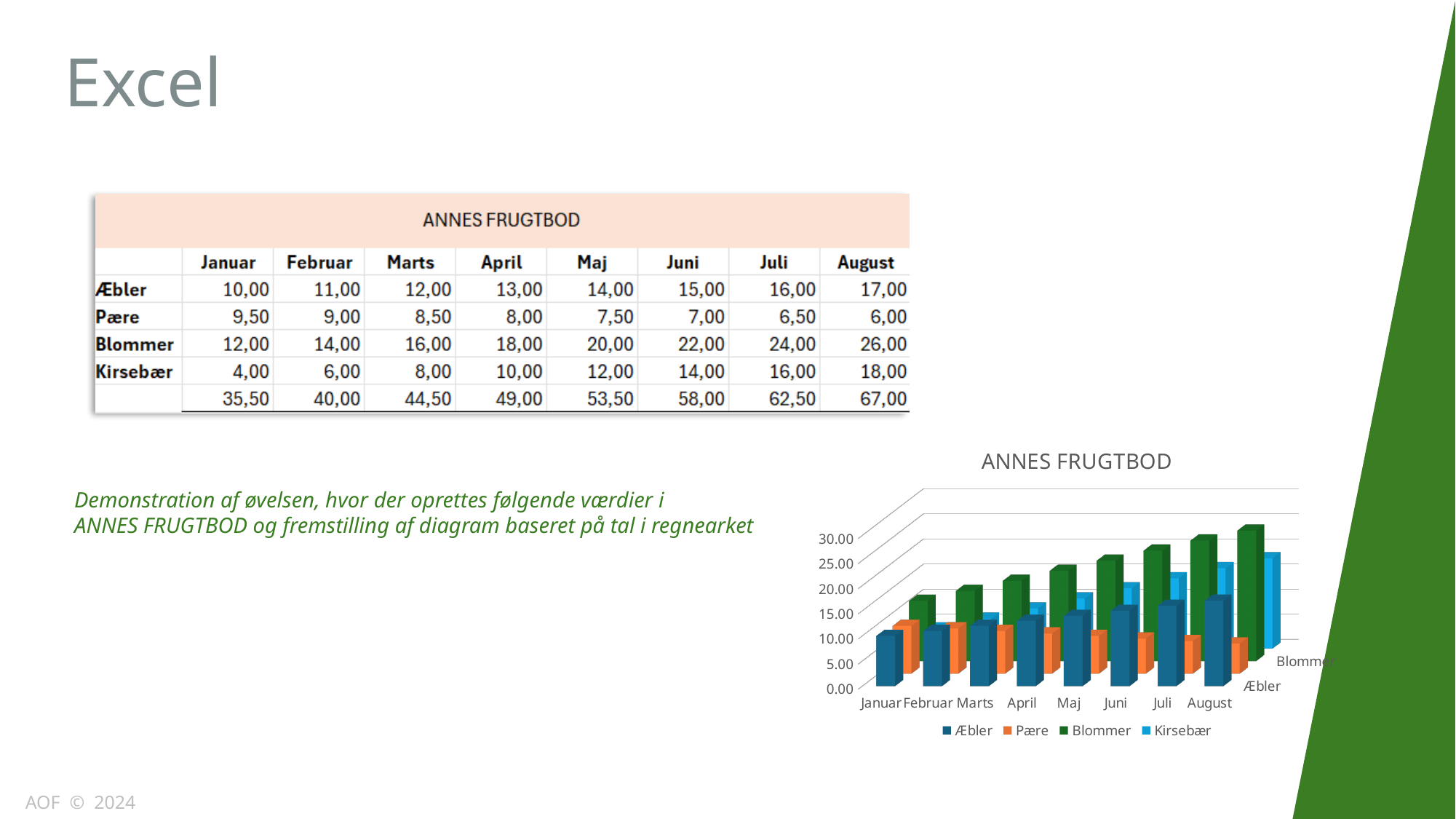
What is the title of the chart? ANNES FRUGTBOD What is the difference between Blommer and Æbler in Januar? 2,00 Do the values for Blommer rise or fall from Januar to August? rise What is the value for Blommer in August? 26,00 What kind of chart is shown on the slide? bar chart Do the values for Pære rise or fall from Januar to August? fall How many series does the chart legend list? 4 Is the value for Blommer in August greater or less than 20.00? greater Is the value for Pære in August greater or less than 10.00? less How many months are shown along the x axis of the chart? 8 Which series has the highest value in August? Blommer Which series has the lowest value in August? Pære